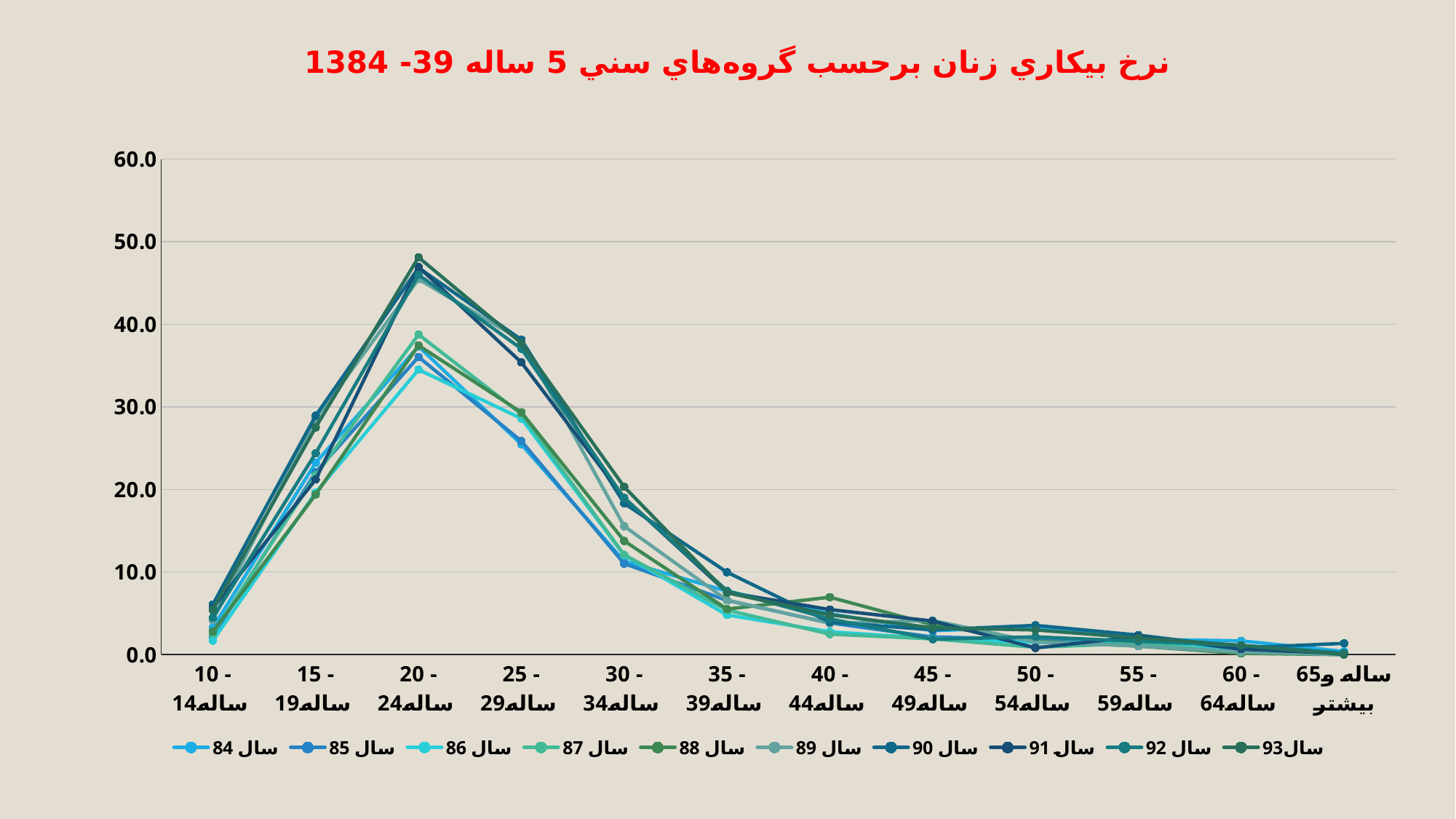
What is the first series listed in the legend? سال 84 How many age-group categories are shown on the x axis? 12 How many series does the legend list? 10 What is the highest value shown on the y axis? 60.0 Do the values rise or fall along the x axis from the 10-14 age group to the 20-24 age group? rise Is the value for the 15-19 age group in سال 92 greater or less than 20? greater Do the values rise or fall along the x axis from the 20-24 age group to the 65 and over age group? fall Is the value for the 20-24 age group in سال 93 greater or less than 40? greater Which age group has the highest unemployment rate for every series? 20-24 ساله Is the value for the 65 and over age group in سال 90 greater or less than 10? less What kind of chart is shown on the slide? line chart